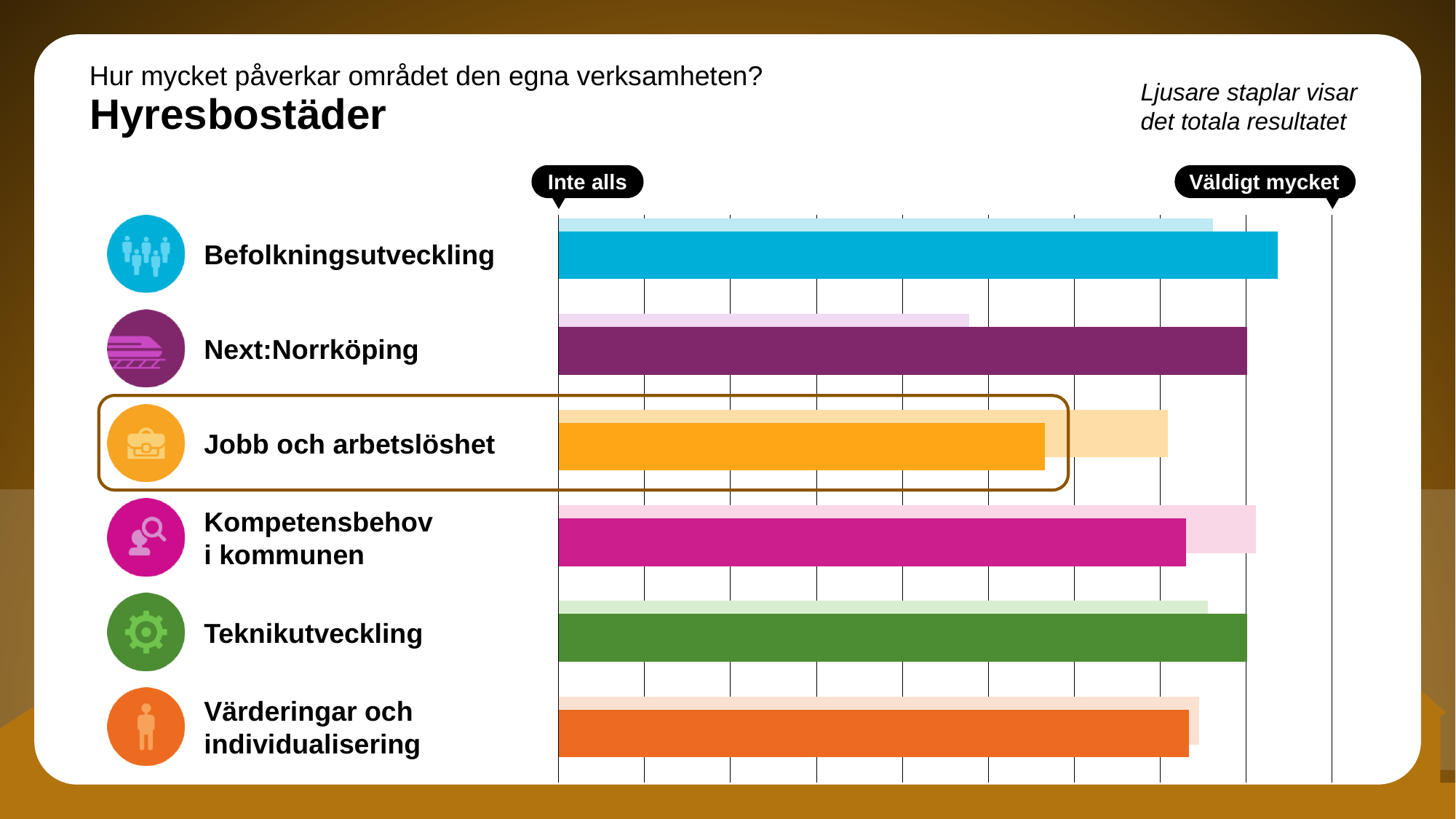
According to the note on the slide, what do the lighter bars show? Det totala resultatet How many categories (areas) are listed in the chart? 6 What kind of chart is shown on the slide? Bar chart For Next:Norrköping, which bar is longer: the dark bar or the light bar? The dark bar Which dark bar is longer: Jobb och arbetslöshet or Kompetensbehov i kommunen? Kompetensbehov i kommunen Which category has the shortest dark bar? Jobb och arbetslöshet Which category has the longest light bar? Kompetensbehov i kommunen What is the label at the left end of the chart's scale? Inte alls Which category has the longest dark bar? Befolkningsutveckling For Jobb och arbetslöshet, which bar is longer: the dark bar or the light bar? The light bar Which category has the shortest light bar? Next:Norrköping